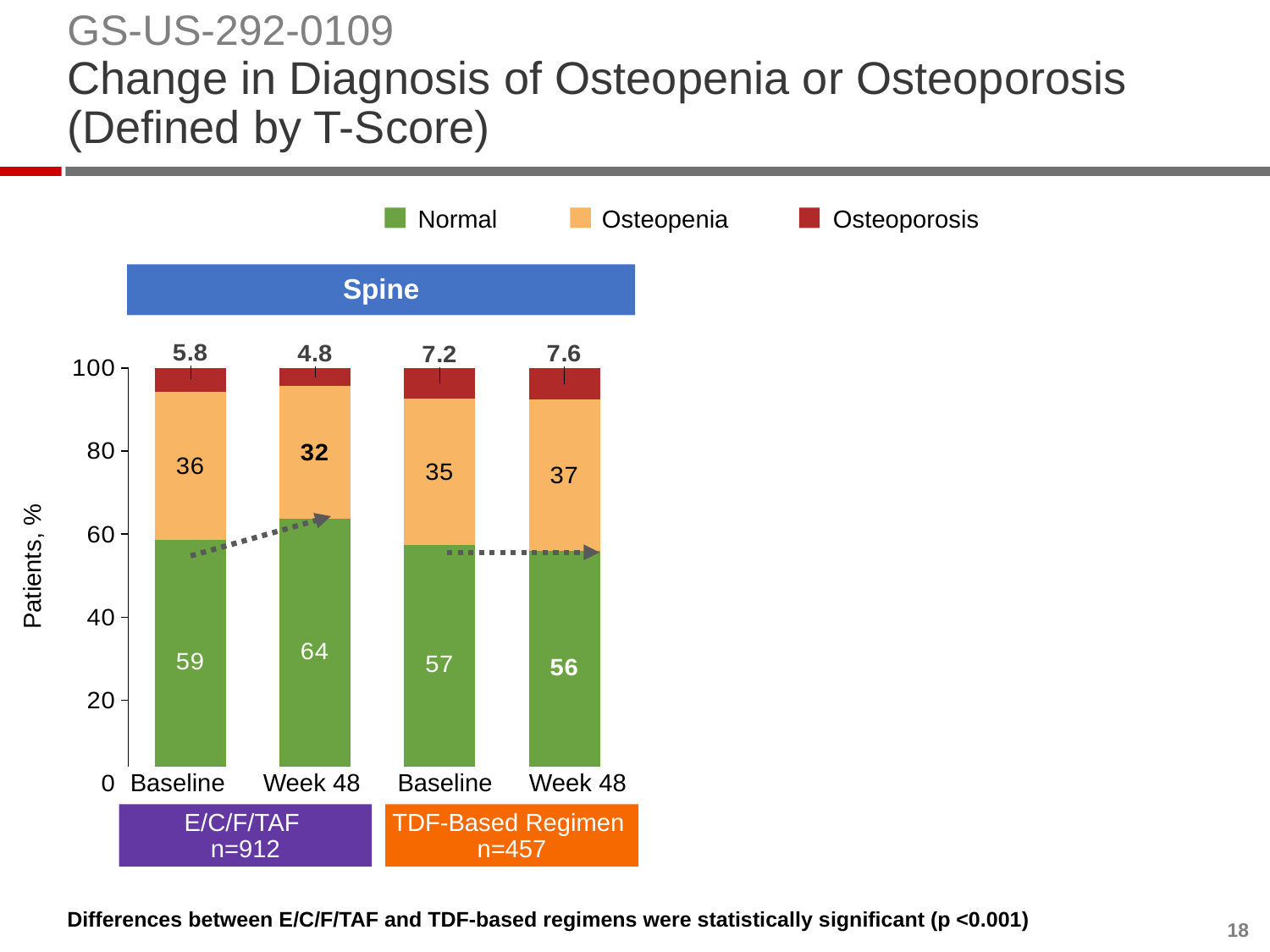
What kind of chart is shown on the slide? Stacked bar chart Which bar has the lowest Osteoporosis value? E/C/F/TAF Week 48 What is the label on the y axis of the chart? Patients, % What is the Osteoporosis value for the TDF-Based Regimen at Week 48? 7.6 What is the Osteopenia value for the E/C/F/TAF group at Baseline? 36 What percentage of E/C/F/TAF patients had a Normal spine T-score at Week 48? 64 How many series does the legend list? 3 Which bar has the highest Normal value? E/C/F/TAF Week 48 What is the difference between the Normal values at Week 48 for E/C/F/TAF and the TDF-Based Regimen? 8 How many bars are shown in the chart? 4 What is the Normal value for the TDF-Based Regimen at Baseline? 57 Which is larger: the Osteopenia value for E/C/F/TAF at Week 48 or for the TDF-Based Regimen at Week 48? TDF-Based Regimen at Week 48